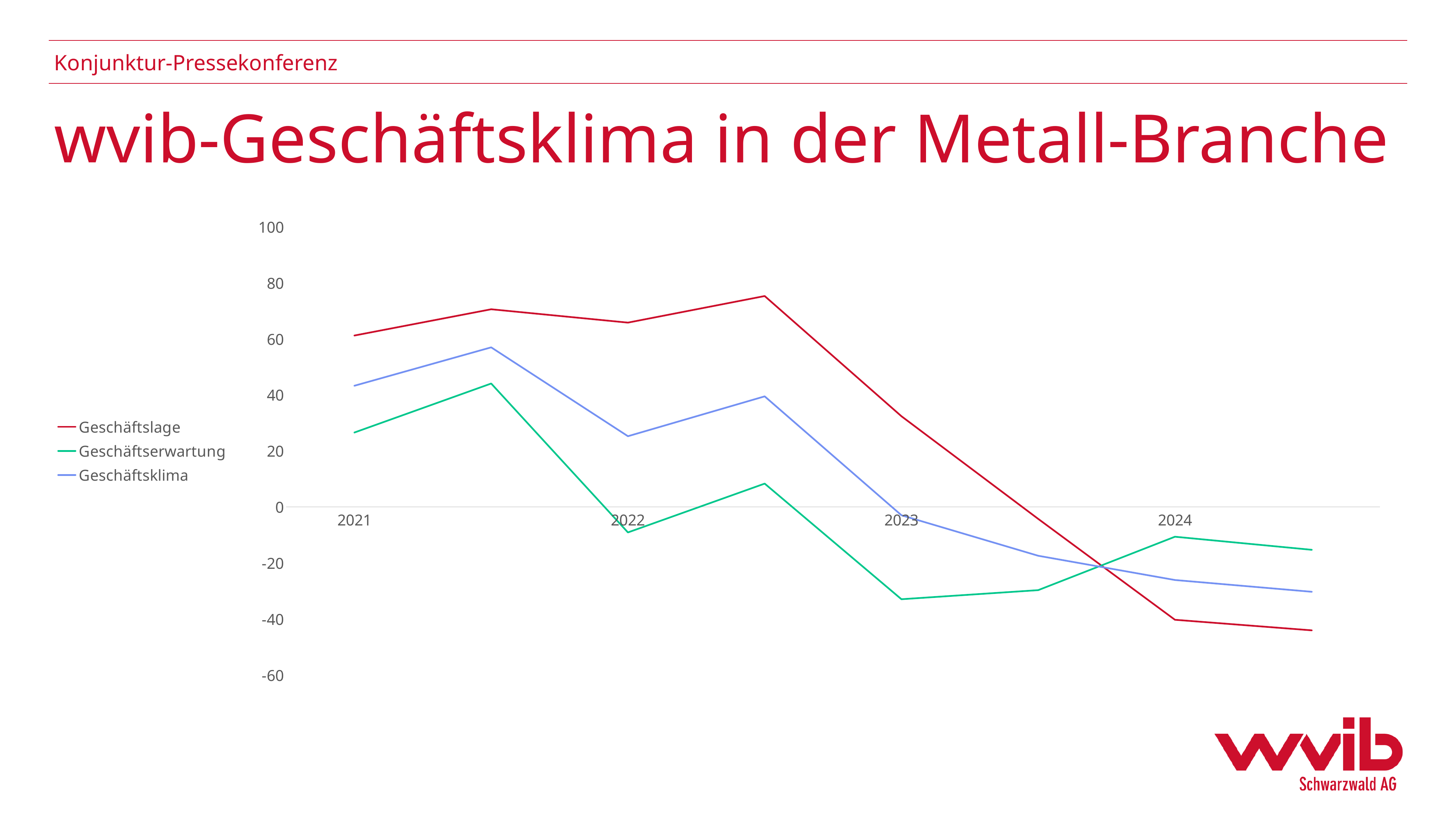
How many series does the legend list? 3 Is the value for Geschäftslage in 2021 greater or less than 40? greater How many year labels are shown on the x axis? 4 What kind of chart is shown on the slide? line chart Is the value for Geschäftslage in 2023 greater or less than 20? greater Which series has the lowest value in 2024? Geschäftslage Is the value for Geschäftserwartung in 2023 greater or less than -20? less In 2024, which is larger: Geschäftserwartung or Geschäftslage? Geschäftserwartung Does the Geschäftslage line rise or fall from 2021 to 2024? fall Which series has the highest value in 2021? Geschäftslage